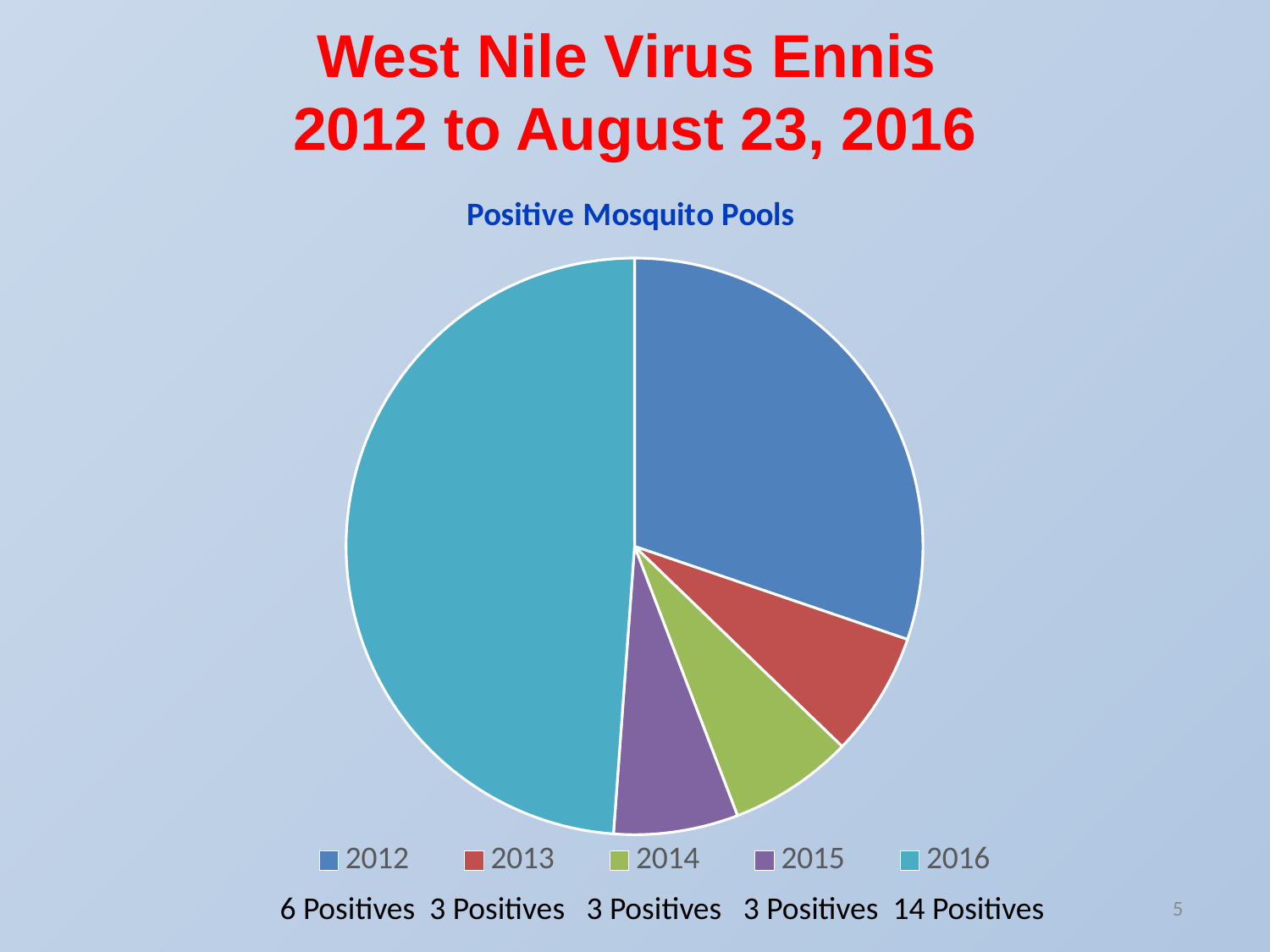
What is the title of the pie chart? Positive Mosquito Pools How many more positives does 2016 have than 2012? 8 How many years (slices) does the pie chart show? 5 Which year has the largest slice of the pie chart? 2016 How many positive mosquito pools are shown for 2012? 6 Positives Which years are tied for the fewest positive mosquito pools? 2013, 2014 and 2015 How many more positives does 2012 have than 2014? 3 What kind of chart is shown on the slide? Pie chart Which year has more positives, 2012 or 2013? 2012 How many positive mosquito pools are shown for 2015? 3 Positives What is the total number of positive mosquito pools across all five years? 29 How many positive mosquito pools are shown for 2016? 14 Positives